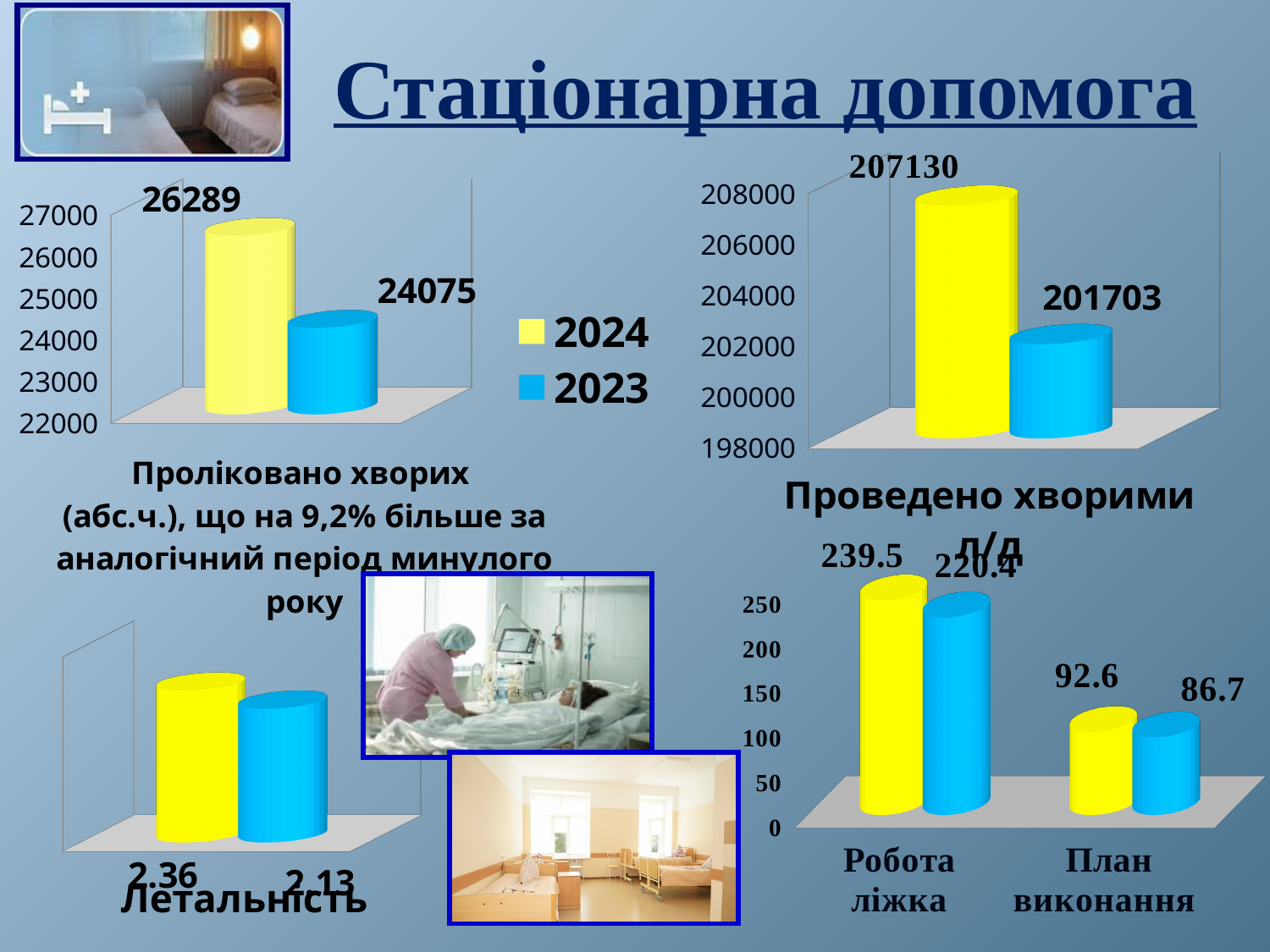
How many series does the legend on the slide list? 2 In the 'Проліковано хворих' chart, what is the difference between the 2024 and 2023 values? 2214 In the bottom-right chart, what is the 2023 value for 'План виконання'? 86.7 In the 'Летальність' chart, what is the value for 2023? 2.13 In the 'Проведено хворими л/д' chart, what is the value for 2023? 201703 In the 'Проведено хворими л/д' chart, which year has the higher value? 2024 In the bottom-right chart, what is the difference between the 2024 and 2023 values for 'План виконання'? 5.9 In the bottom-right chart, what is the 2024 value for 'Робота ліжка'? 239.5 In the 'Проведено хворими л/д' chart, what is the value for 2024? 207130 In the 'Летальність' chart, what is the value for 2024? 2.36 In the 'Проліковано хворих' chart, what is the value for 2024? 26289 In the 'Проліковано хворих' chart, what is the value for 2023? 24075